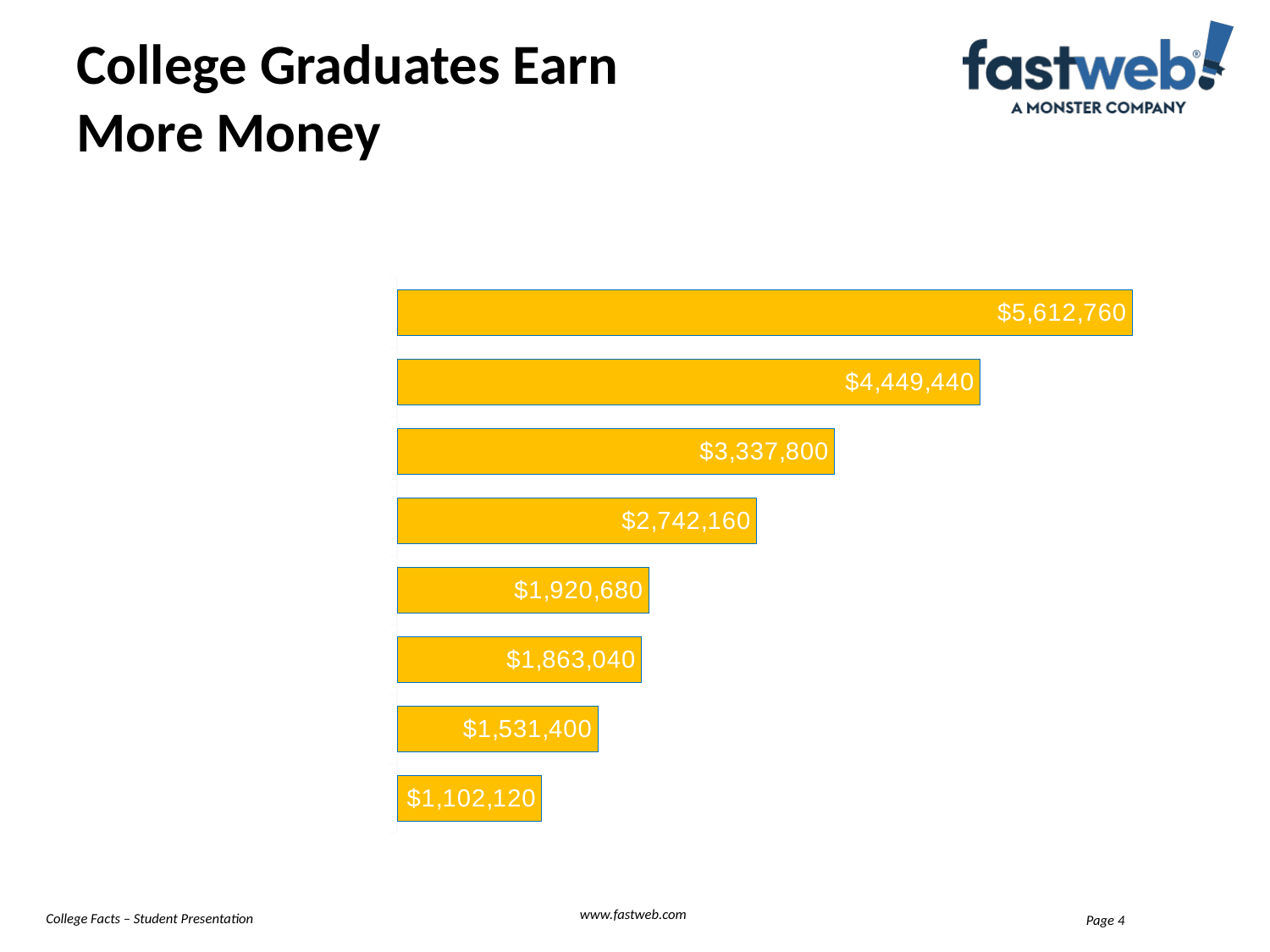
What value is labelled on the second bar from the bottom? $1,531,400 What is the value of the longest bar in the chart? $5,612,760 What is the difference between the values of the top two bars? $1,163,320 What is the value of the shortest bar in the chart? $1,102,120 What value is labelled on the third bar from the top? $3,337,800 How many bars does the chart show? 8 Do the bar values increase or decrease going from the top bar to the bottom bar? decrease What value is labelled on the second bar from the top? $4,449,440 Which is larger, the value of the fifth bar from the top or the sixth bar from the top? the fifth bar ($1,920,680) What value is labelled on the fourth bar from the top? $2,742,160 What kind of chart is shown on the slide? bar chart What is the difference between the top bar's value and the bottom bar's value? $4,510,640